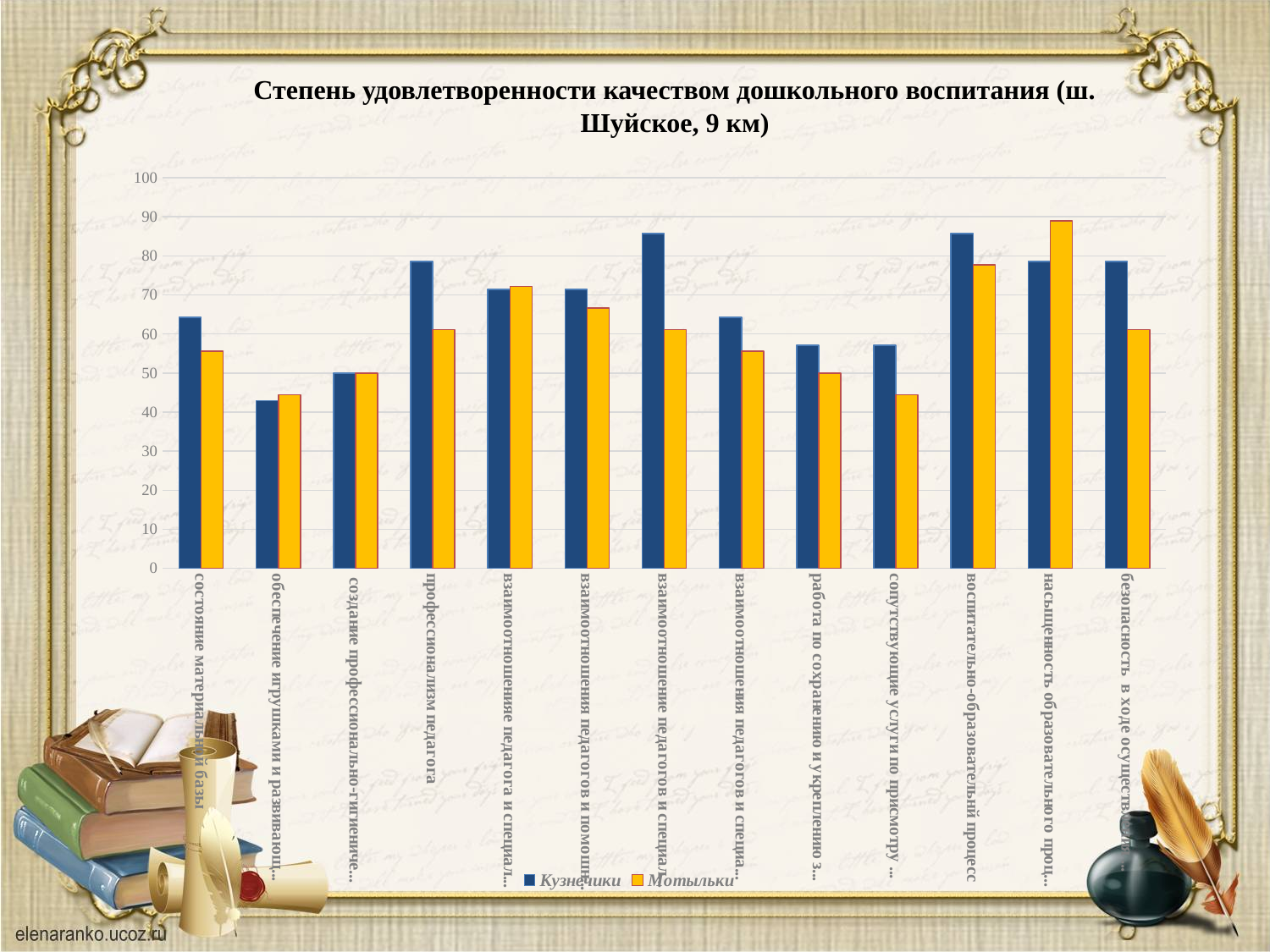
What are the two series named in the legend? Кузнечики and Мотыльки How many series does the legend list? 2 Is the Мотыльки value for насыщенность образовательного проц... greater or less than 80? greater How many categories are shown along the x axis? 13 What kind of chart is shown on the slide? bar chart Is the Кузнечики value for обеспечение игрушками и развивающ... greater or less than 50? less For профессионализм педагога, which series has the larger value, Кузнечики or Мотыльки? Кузнечики Which category has the lowest value for the Кузнечики series? обеспечение игрушками и развивающ... Which category has the highest value for the Мотыльки series? насыщенность образовательного проц... For насыщенность образовательного проц..., which series has the larger value, Кузнечики or Мотыльки? Мотыльки Is the Мотыльки value for профессионализм педагога greater or less than 70? less